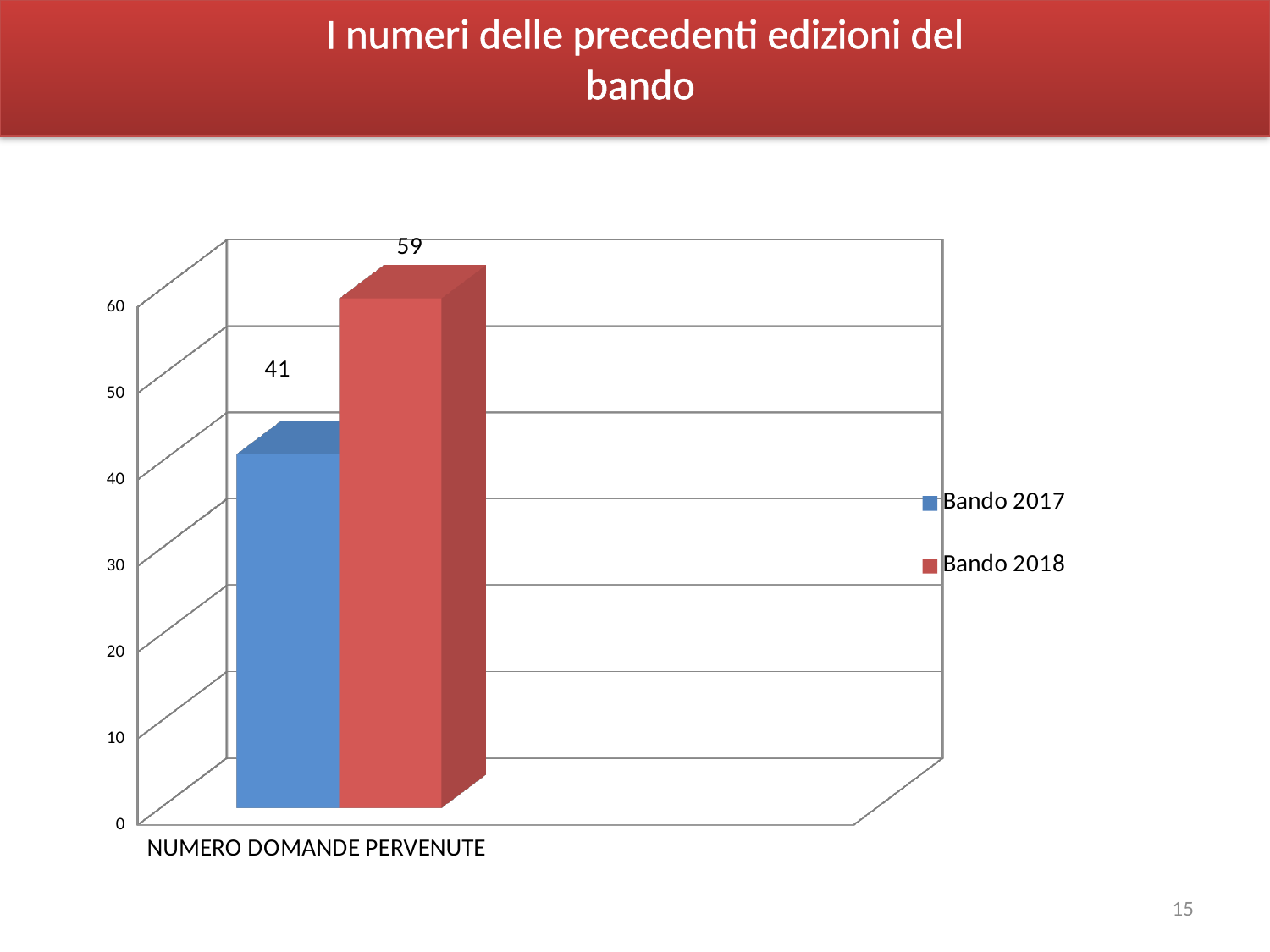
What colour is the bar for Bando 2018? red What is the category label shown on the x axis of the chart? NUMERO DOMANDE PERVENUTE What is the value for Bando 2017 in the chart? 41 Is the value for Bando 2017 greater or less than 50? less How many series does the legend list? 2 Is the value for Bando 2018 greater or less than 50? greater What is the value for Bando 2018 in the chart? 59 Is the value for Bando 2017 larger or smaller than the value for Bando 2018? smaller What kind of chart is shown on the slide? bar chart Which series has the lower value in the chart? Bando 2017 Which series has the higher value, Bando 2017 or Bando 2018? Bando 2018 What is the difference between the Bando 2018 value and the Bando 2017 value? 18